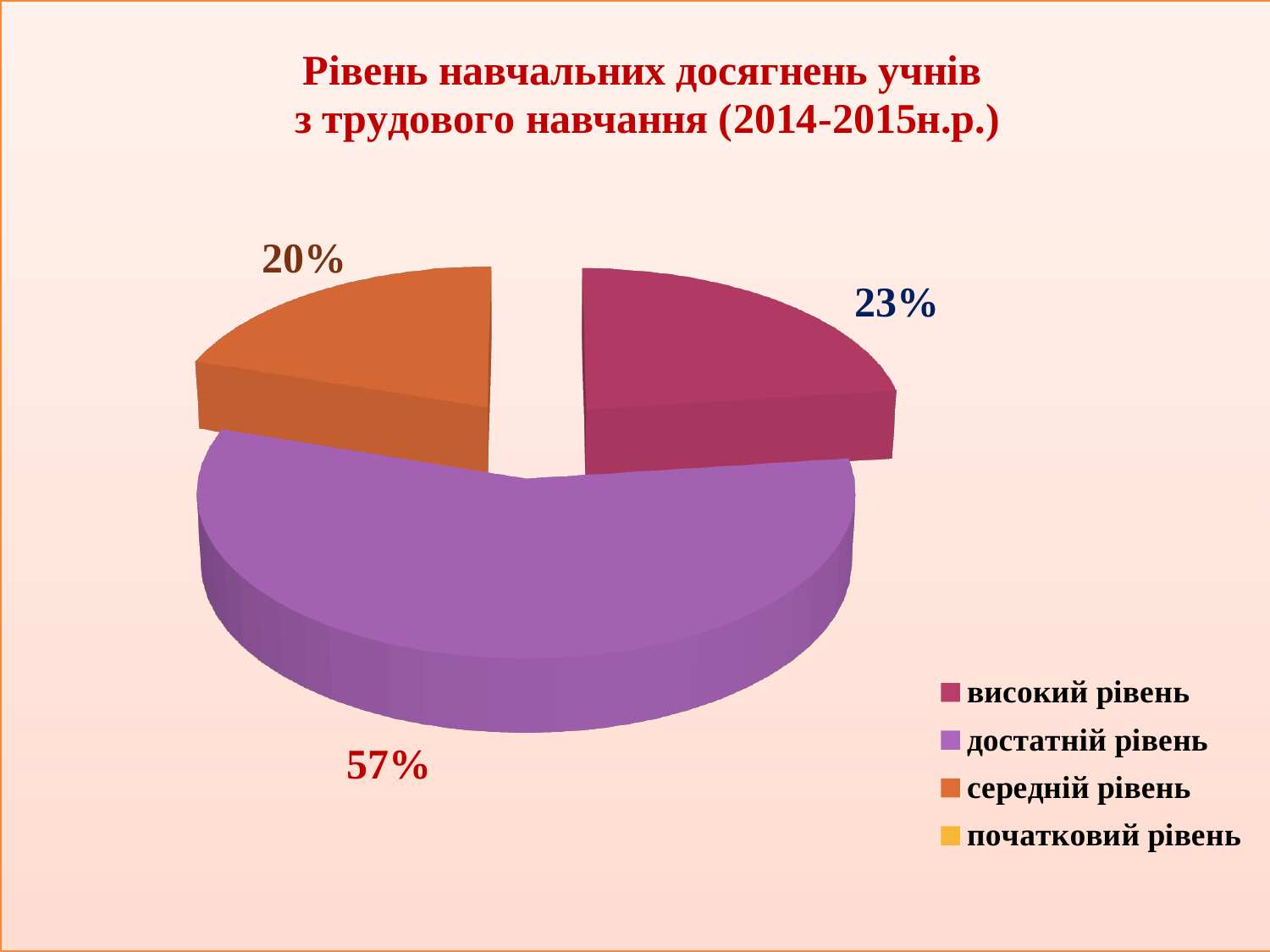
What share of the pie does "достатній рівень" have? 57% Which of the visible slices is the smallest? середній рівень What kind of chart is shown on the slide? pie chart How many slices are visible in the pie? 3 Which is larger, the share of "достатній рівень" or the share of "середній рівень"? достатній рівень How many entries does the legend list? 4 What share of the pie does "високий рівень" have? 23% What is the difference between the shares of "достатній рівень" and "високий рівень"? 34% What is the difference between the shares of "високий рівень" and "середній рівень"? 3% What colour is the slice for "достатній рівень"? purple Which category has the largest slice of the pie? достатній рівень What share of the pie does "середній рівень" have? 20%